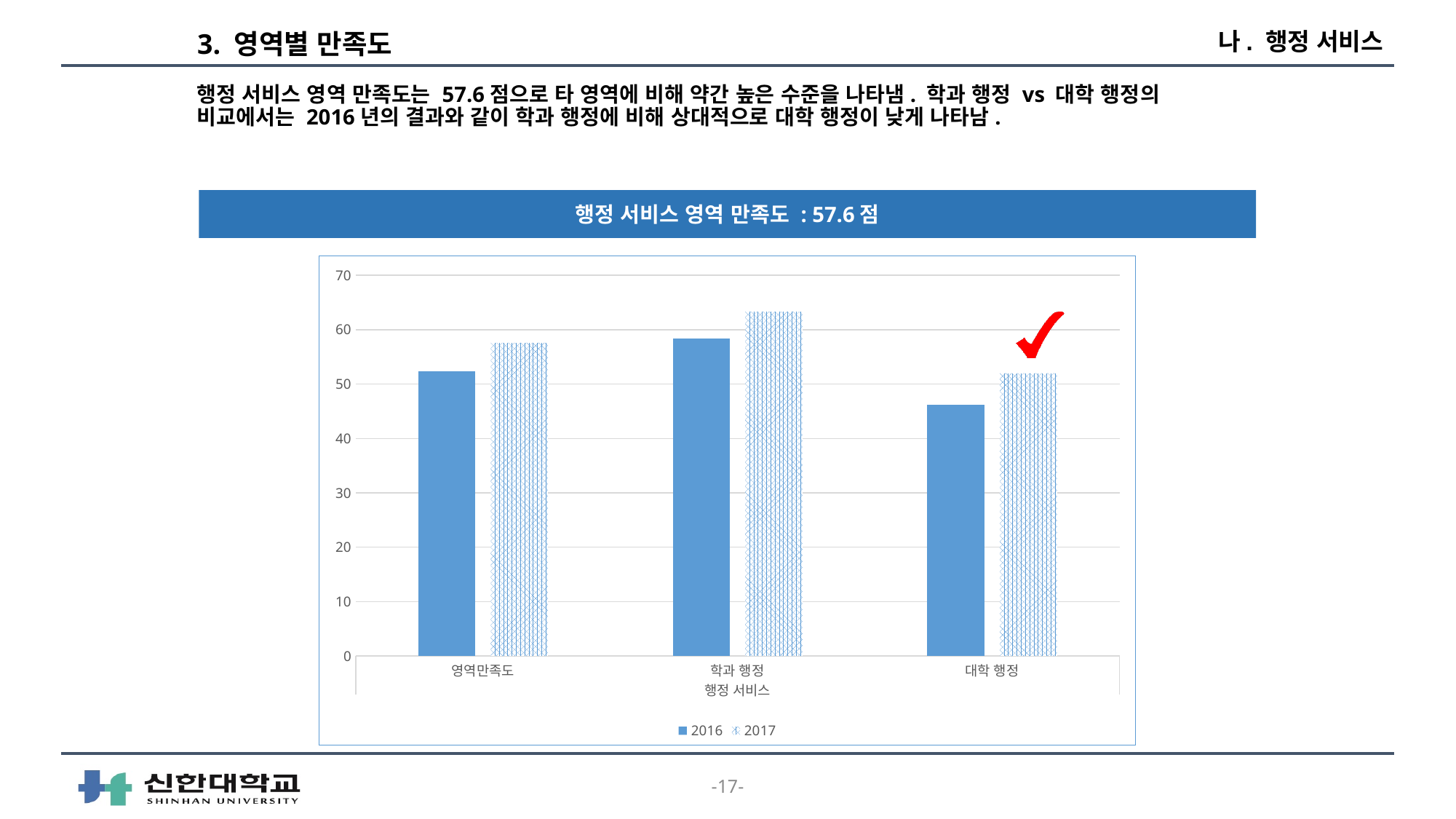
Is the 2017 value for 학과 행정 greater or less than 60? greater Is the 2017 value for 대학 행정 greater or less than 50? greater Is the 2016 value for 대학 행정 greater or less than 50? less What are the two legend entries of the chart? 2016 and 2017 How many series does the chart legend list? 2 How many categories are shown on the x axis of the chart? 3 What kind of chart is shown on the slide? bar chart Which category has the lowest 2016 bar? 대학 행정 For 학과 행정, which series has the larger value, 2016 or 2017? 2017 Which category has the highest 2017 bar? 학과 행정 Which is larger in 2016: 학과 행정 or 대학 행정? 학과 행정